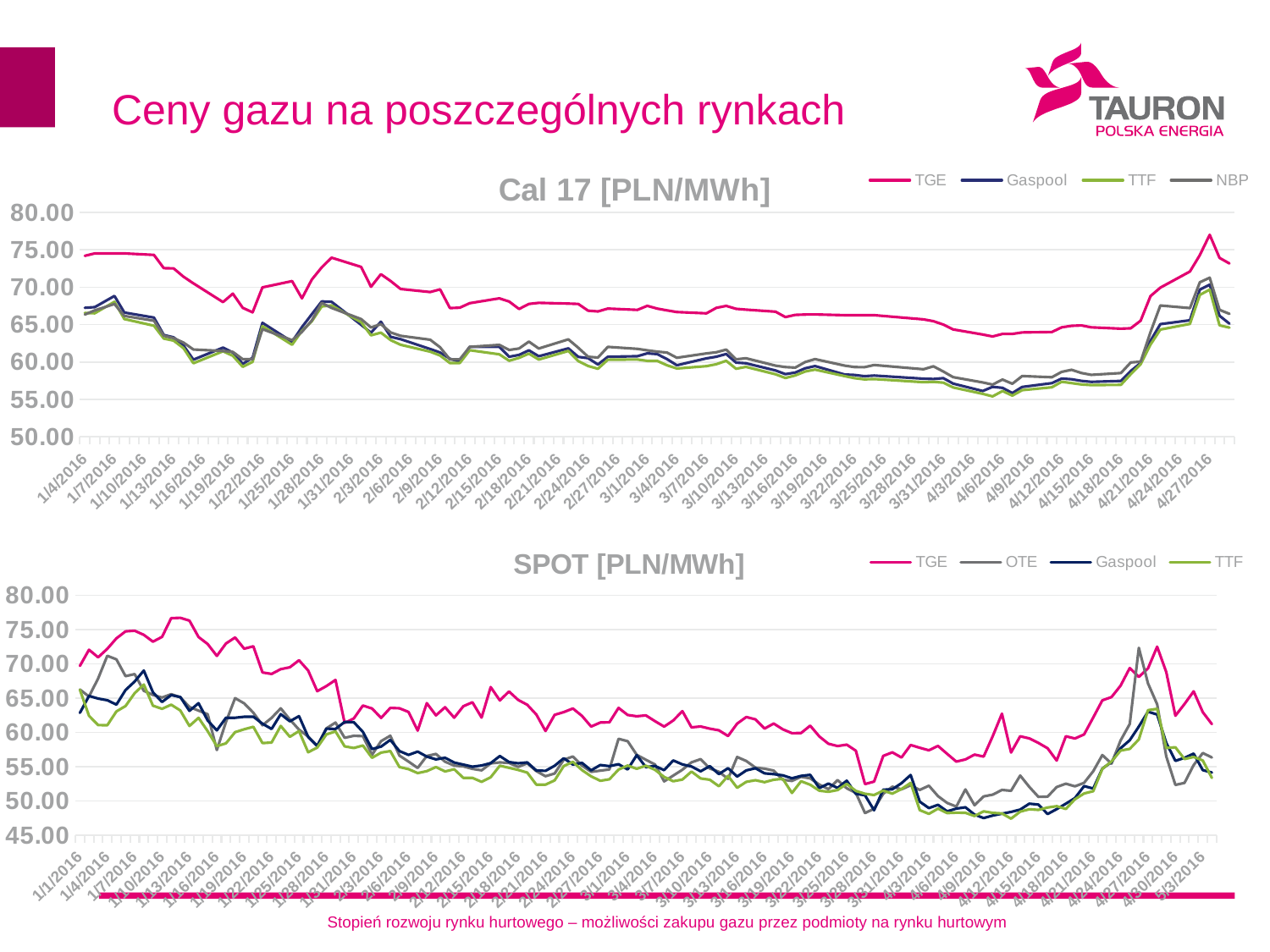
In the SPOT [PLN/MWh] chart, is the TTF value on 4/9/2016 greater or less than 50.00? less What colour is the TGE line in both charts? pink In the Cal 17 [PLN/MWh] chart, is the TGE value on 1/4/2016 greater or less than 70.00? greater In the Cal 17 [PLN/MWh] chart, which series has the highest values across the whole period? TGE In the SPOT [PLN/MWh] chart, which is larger on 2/15/2016, TGE or TTF? TGE In the Cal 17 [PLN/MWh] chart, does the TGE series rise or fall between 1/4/2016 and 4/6/2016? fall In the Cal 17 [PLN/MWh] chart, is the TTF value on 4/6/2016 greater or less than 60.00? less How many series does the legend of the SPOT [PLN/MWh] chart list? 4 How many series does the legend of the Cal 17 [PLN/MWh] chart list? 4 Which series appears in the legend of the SPOT [PLN/MWh] chart but not in the Cal 17 [PLN/MWh] chart? OTE What kind of chart is the Cal 17 [PLN/MWh] chart? line chart